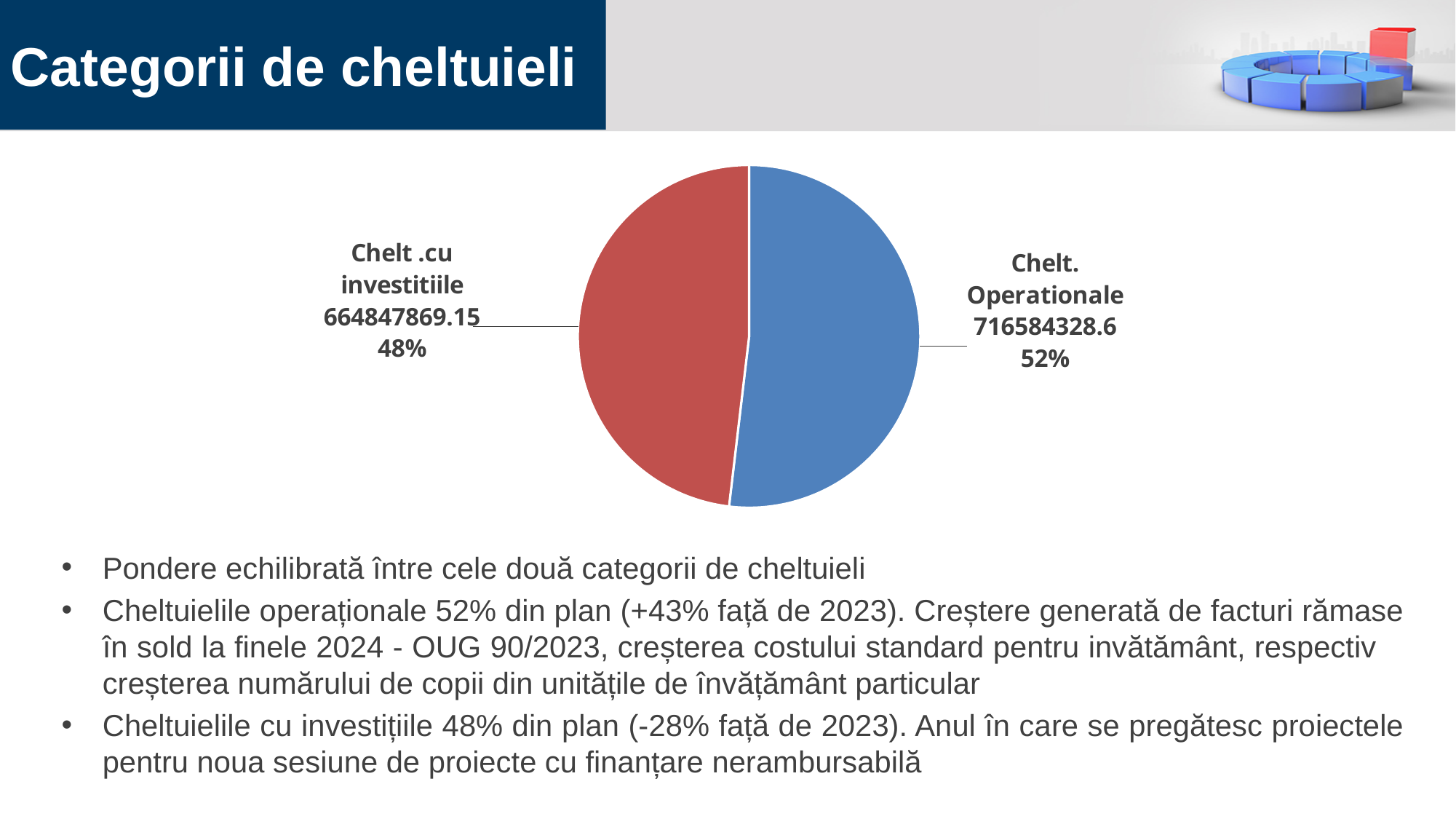
Which is larger, Chelt. Operationale or Chelt .cu investitiile? Chelt. Operationale What type of chart is shown on the slide? Pie chart How many categories are shown in the pie chart? 2 What is the value shown for Chelt. Operationale? 716584328.6 What percentage share of the pie does Chelt .cu investitiile have? 48% Which category has the largest slice of the pie? Chelt. Operationale What colour is the Chelt. Operationale slice? Blue What is the difference between the value for Chelt. Operationale and the value for Chelt .cu investitiile? 51736459.45 Which category has the smallest slice of the pie? Chelt .cu investitiile What is the total of the two values shown in the pie chart? 1381432197.75 What is the value shown for Chelt .cu investitiile? 664847869.15 What percentage share of the pie does Chelt. Operationale have? 52%